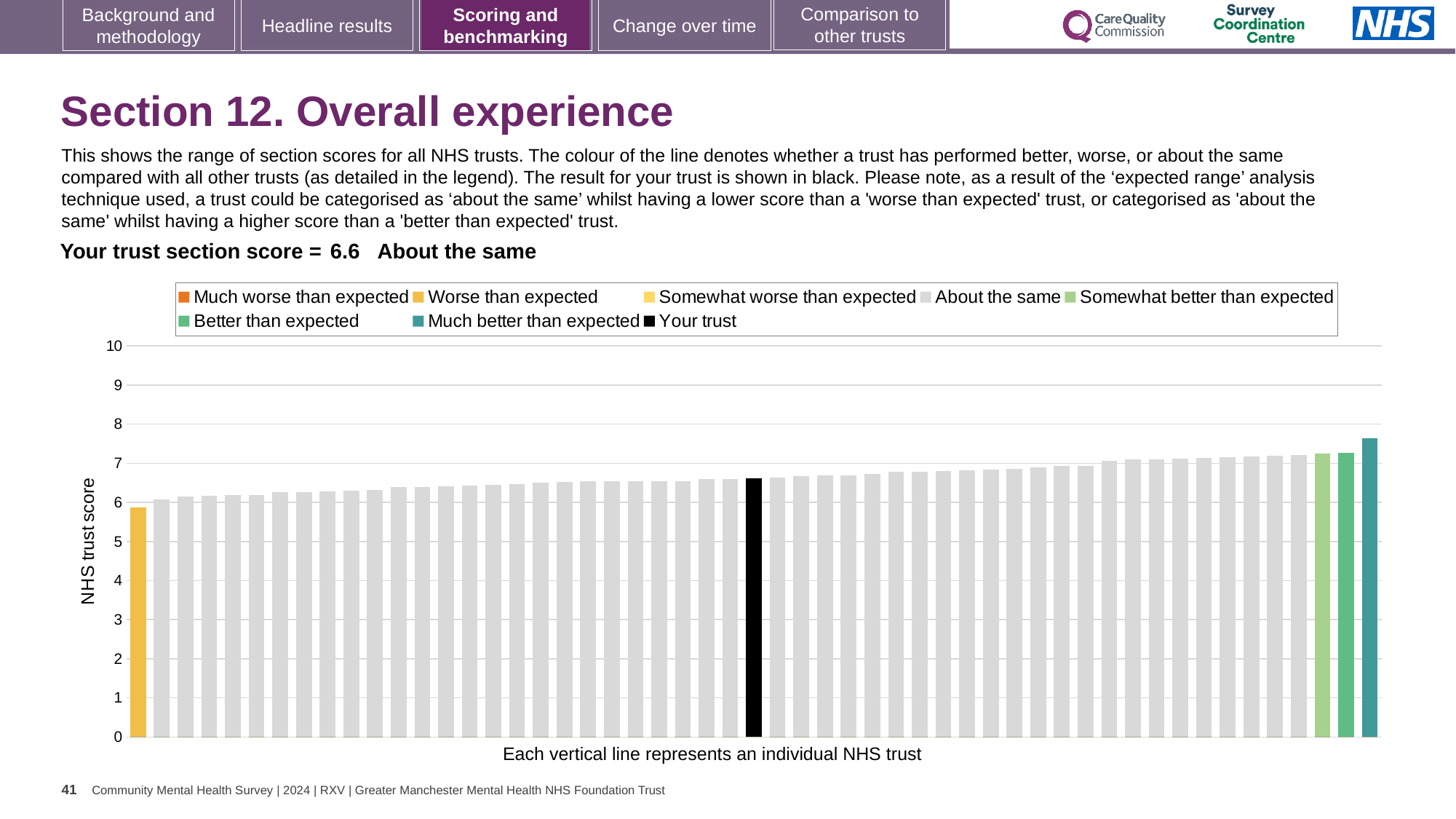
Which benchmarking category is the trust's section score placed in? About the same Which legend category does the leftmost (yellow) bar belong to? Worse than expected Is the value of the tallest bar greater or less than 8? less What is the label on the vertical axis of the chart? NHS trust score What is the trust's section score shown on the slide? 6.6 Is the value of the tallest bar (rightmost) greater or less than 7? greater What kind of chart is shown on the slide? bar chart Is the value of the shortest bar (leftmost) greater or less than 5? greater Do the bar values rise or fall from left to right along the x axis? rise How many entries does the chart legend list? 8 What colour is used for the bar representing your trust? black